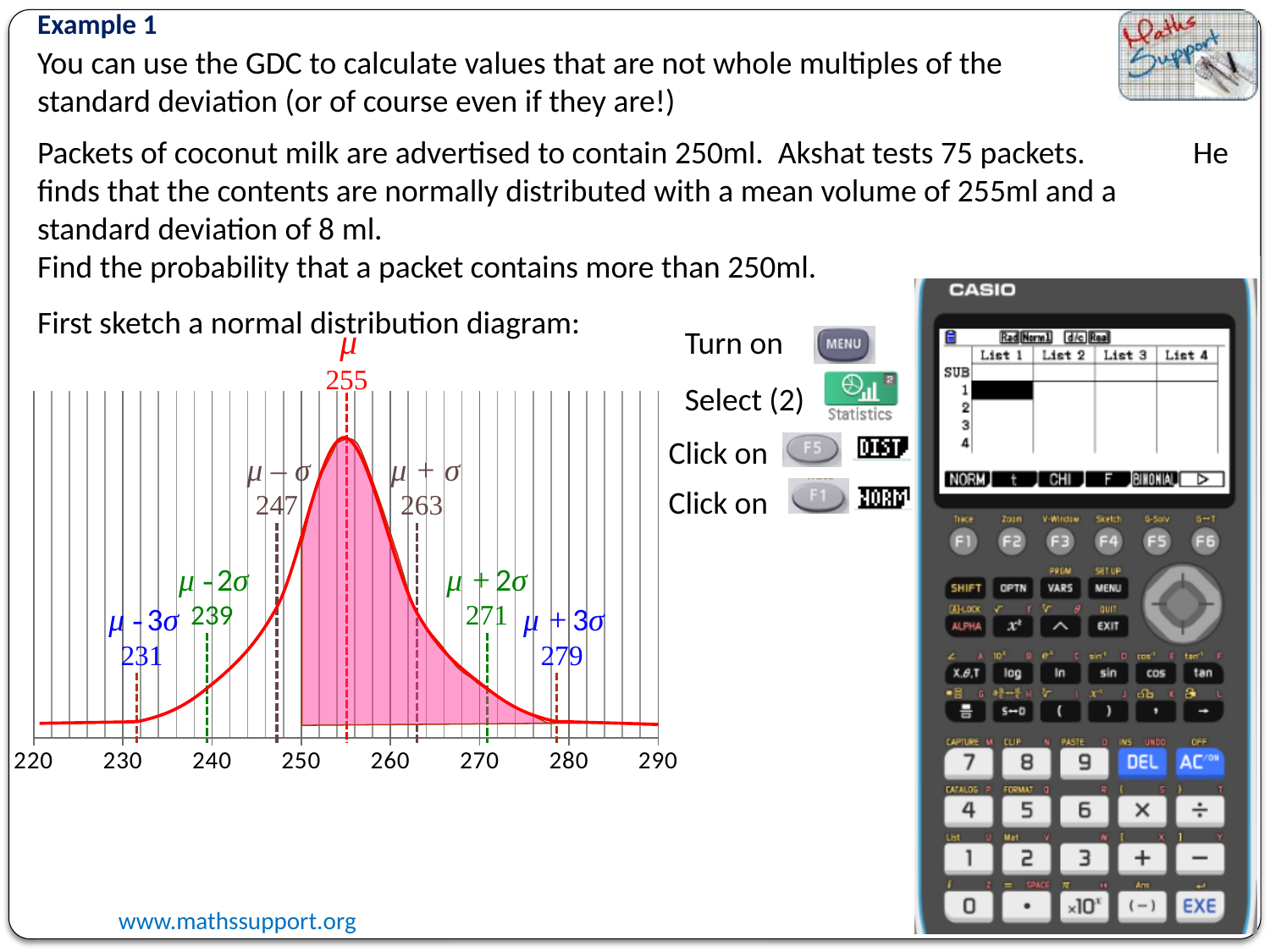
What value is labelled at μ − 3σ on the normal distribution diagram? 231 What is the highest value shown on the horizontal axis of the normal distribution diagram? 290 What value is labelled at μ + 3σ on the normal distribution diagram? 279 What value is labelled at μ − σ on the normal distribution diagram? 247 What is the difference between the values labelled at μ + 3σ and μ on the diagram? 24 What value is labelled at μ + σ on the normal distribution diagram? 263 What value is labelled at μ + 2σ on the normal distribution diagram? 271 What value is labelled at the mean (μ) on the normal distribution diagram? 255 What is the lowest value shown on the horizontal axis of the normal distribution diagram? 220 What is the difference between the values labelled at μ + σ and μ − σ on the diagram? 16 At what horizontal-axis value does the pink shaded region of the diagram begin? 250 Which is larger on the diagram, the value labelled at μ − 2σ or the value labelled at μ − σ? μ − σ